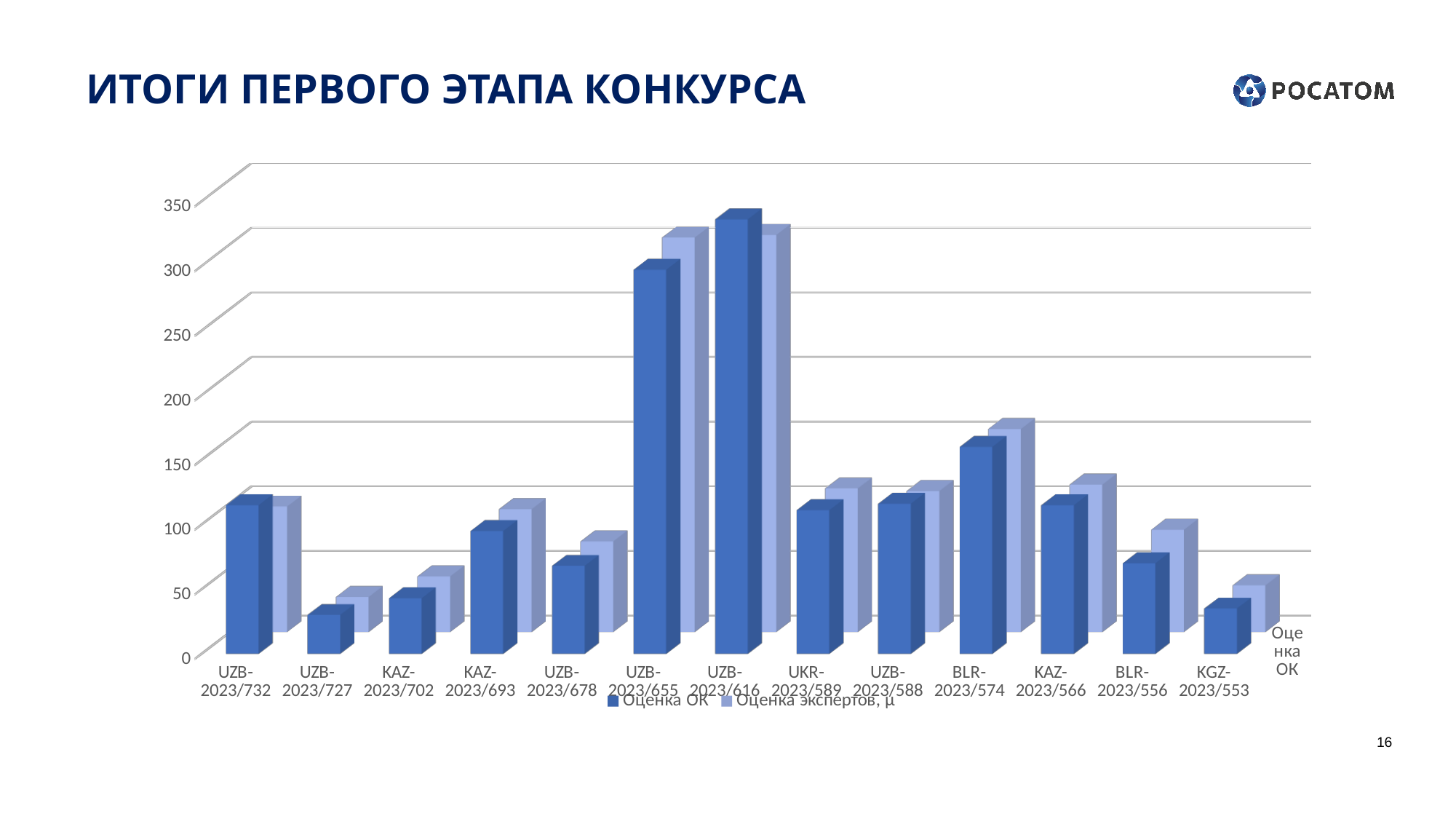
Which has the larger Оценка ОК value: UZB-2023/616 or UZB-2023/655? UZB-2023/616 How many series does the legend list? 2 Which category has the highest value for the series Оценка ОК? UZB-2023/616 What is the title of the slide containing the chart? ИТОГИ ПЕРВОГО ЭТАПА КОНКУРСА Which has the larger Оценка ОК value: UZB-2023/655 or BLR-2023/574? UZB-2023/655 Is the Оценка ОК value for UZB-2023/727 greater or less than 50? less Is the Оценка ОК value for UZB-2023/616 greater or less than 300? greater How many categories (project codes) are shown on the x axis? 13 Is the Оценка ОК value for UZB-2023/655 greater or less than 250? greater What kind of chart is shown on the slide? bar chart